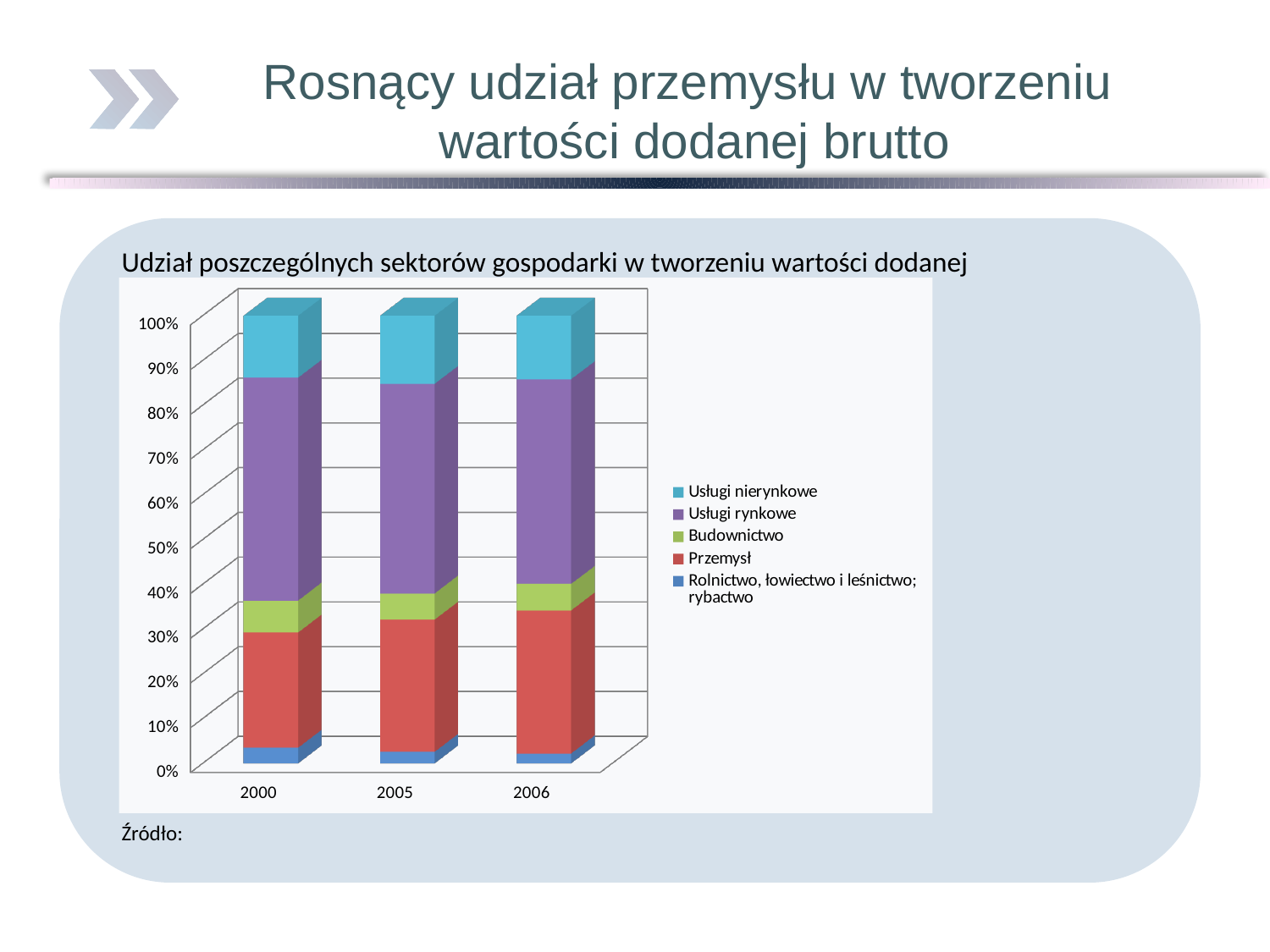
What kind of chart is shown on the slide? stacked bar chart How many series does the chart legend list? 5 Does the share of Przemysł rise or fall from 2000 to 2006? rise Is the share of Rolnictwo, łowiectwo i leśnictwo; rybactwo in 2000 greater or less than 10%? less Which legend entry is shown in red? Przemysł Which sector has the smallest share of the bar for 2000? Rolnictwo, łowiectwo i leśnictwo; rybactwo Is the share of Usługi nierynkowe in 2006 greater or less than 20%? less What is the total of the stacked bar for 2005? 100% What is the title of the chart? Udział poszczególnych sektorów gospodarki w tworzeniu wartości dodanej Which sector has the largest share of the bar for 2006? Usługi rynkowe Is the share of Przemysł in 2006 greater or less than 20%? greater How many years (categories) are shown on the x axis of the chart? 3